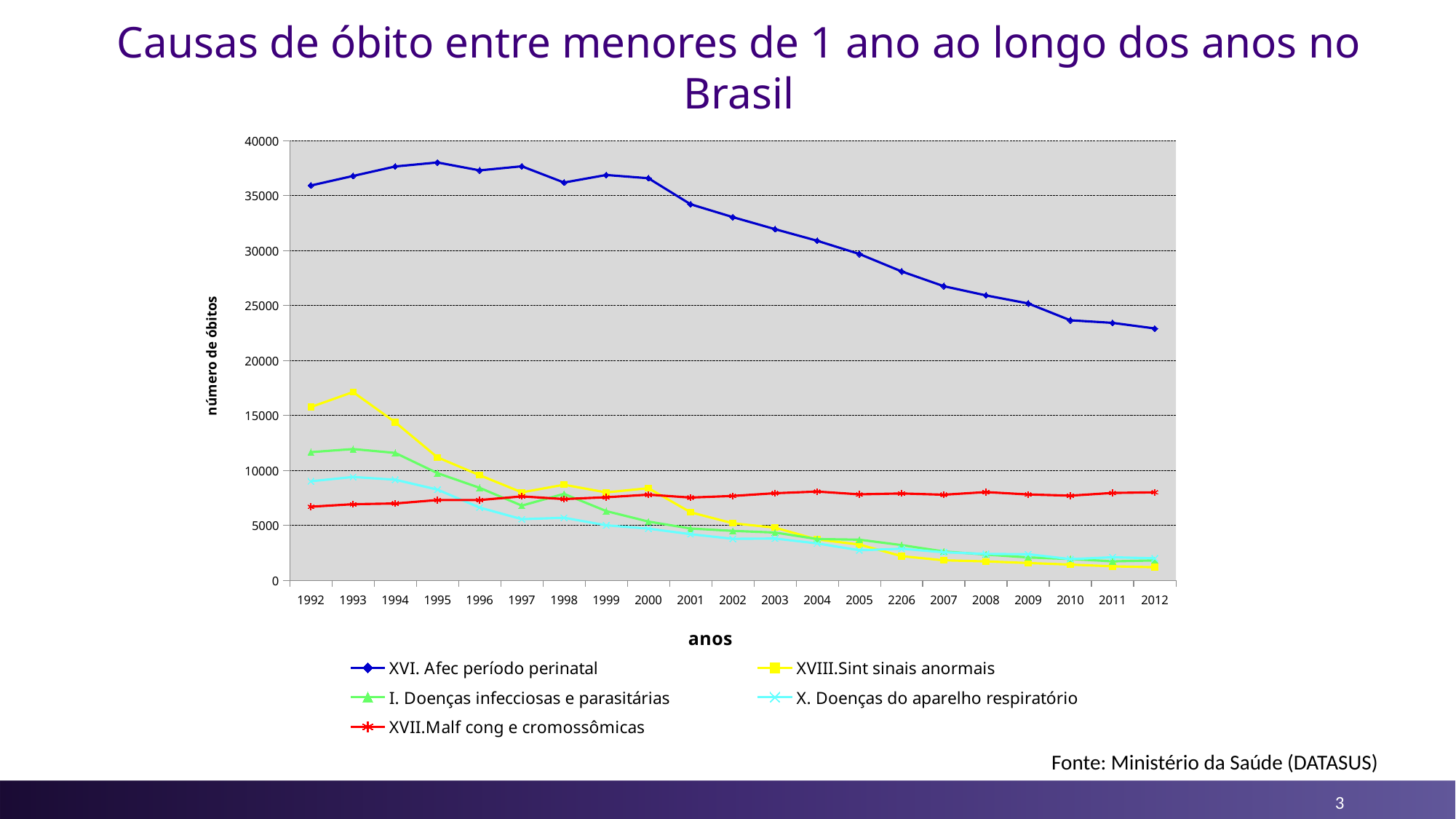
Is the value for I. Doenças infecciosas e parasitárias in 1992 greater or less than 10000? greater What kind of chart is shown on the slide? line chart Does the XVI. Afec período perinatal series rise or fall overall from 1992 to 2012? fall Which series has the highest value in 1992? XVI. Afec período perinatal Is the value for XVIII.Sint sinais anormais in 1993 greater or less than 15000? greater What is the title of the y axis? número de óbitos Which series has the lowest value in 2012? XVIII.Sint sinais anormais Is the value for XVI. Afec período perinatal in 2012 greater or less than 25000? less In 2012, which series is higher: XVI. Afec período perinatal or XVII.Malf cong e cromossômicas? XVI. Afec período perinatal How many series does the legend list? 5 How many years are plotted along the x axis? 21